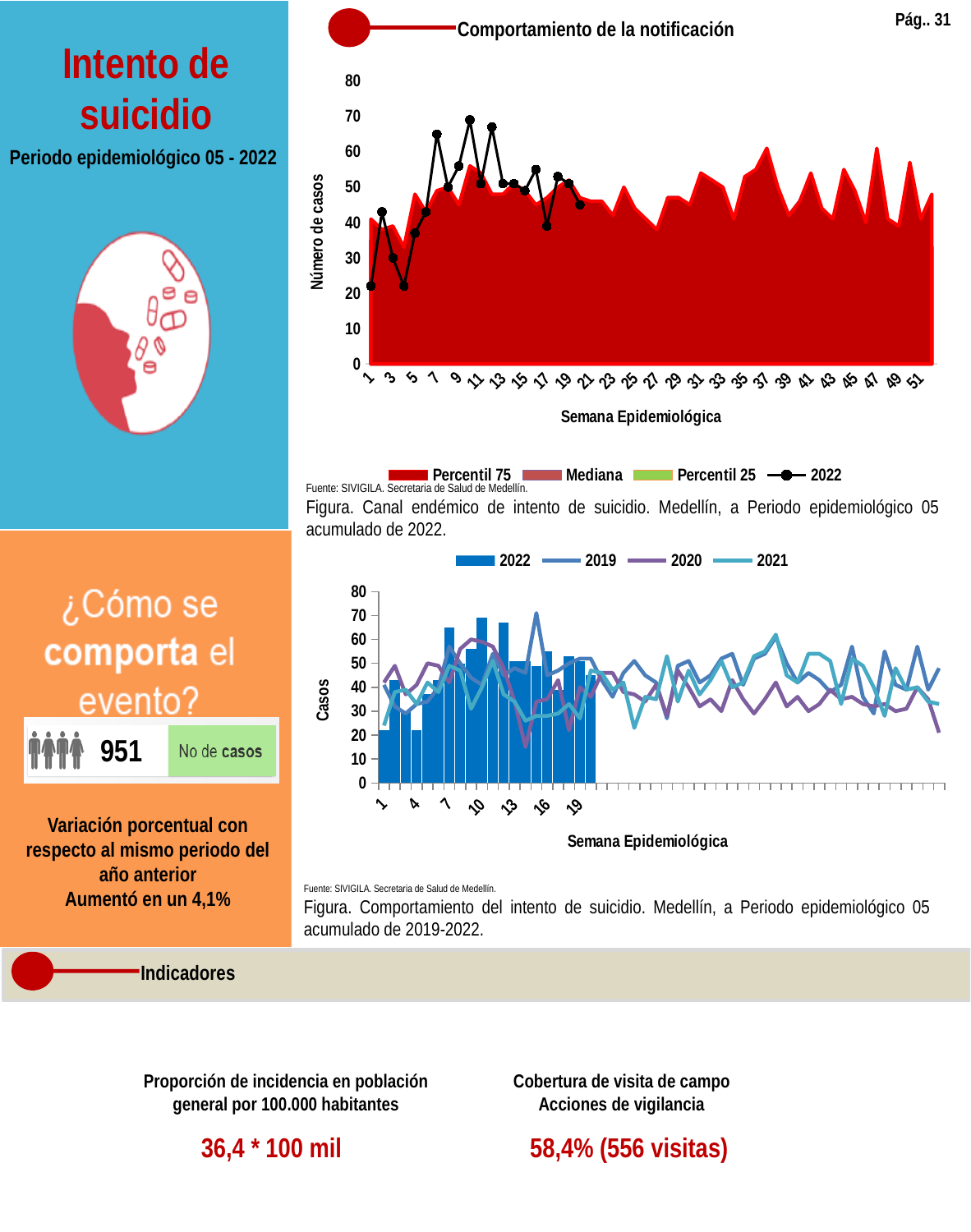
In the bottom chart, is the 2022 bar for week 1 greater or less than 30? less In the bottom chart, which is larger for 2022: the bar for week 7 or the bar for week 4? week 7 In the top chart, does the 2022 line rise or fall overall from week 1 to week 9? rise In the top chart, is the 2022 value for week 9 greater or less than 60? less In the top chart (Canal endémico), how many series does the legend list? 4 What kind of chart is the bottom chart showing 2019-2022? bar chart with line series In the top chart, is the 2022 value for week 4 greater or less than 30? less In the bottom chart (Comportamiento del intento de suicidio), how many series does the legend list? 4 What is the y-axis title of the top chart? Número de casos What is the x-axis title of the top chart? Semana Epidemiológica